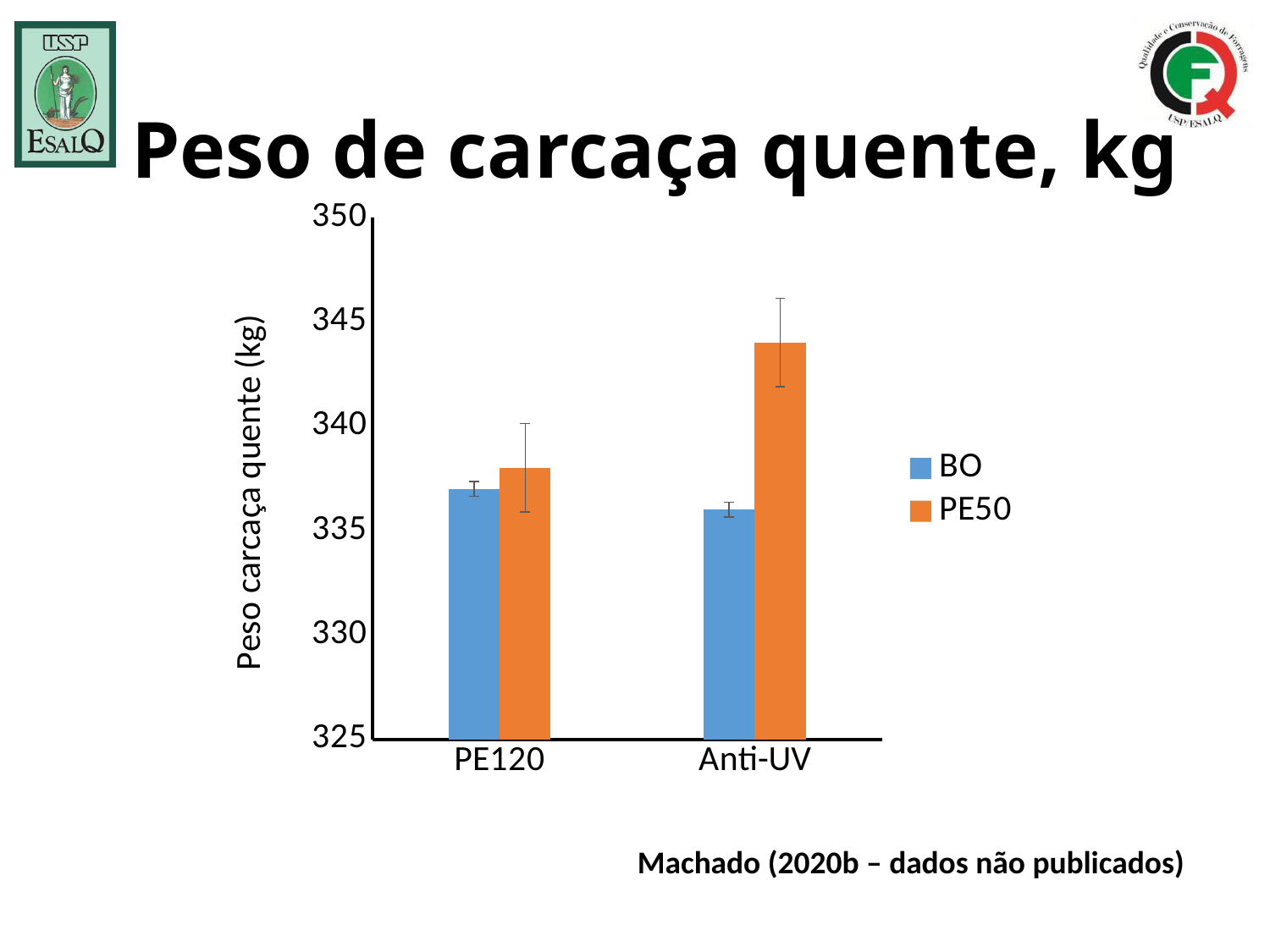
Is the PE50 value for Anti-UV greater or less than 340? greater What kind of chart is shown on the slide? bar chart How many categories are shown on the x axis? 2 Which series and category combination has the highest bar? PE50 for Anti-UV What is the title of the slide? Peso de carcaça quente, kg Is the BO value for PE120 greater or less than 335? greater Is the PE50 value for PE120 greater or less than 340? less What colour represents the PE50 series? orange Which category has the higher PE50 value, PE120 or Anti-UV? Anti-UV For Anti-UV, which series has the larger value, BO or PE50? PE50 How many series does the legend list? 2